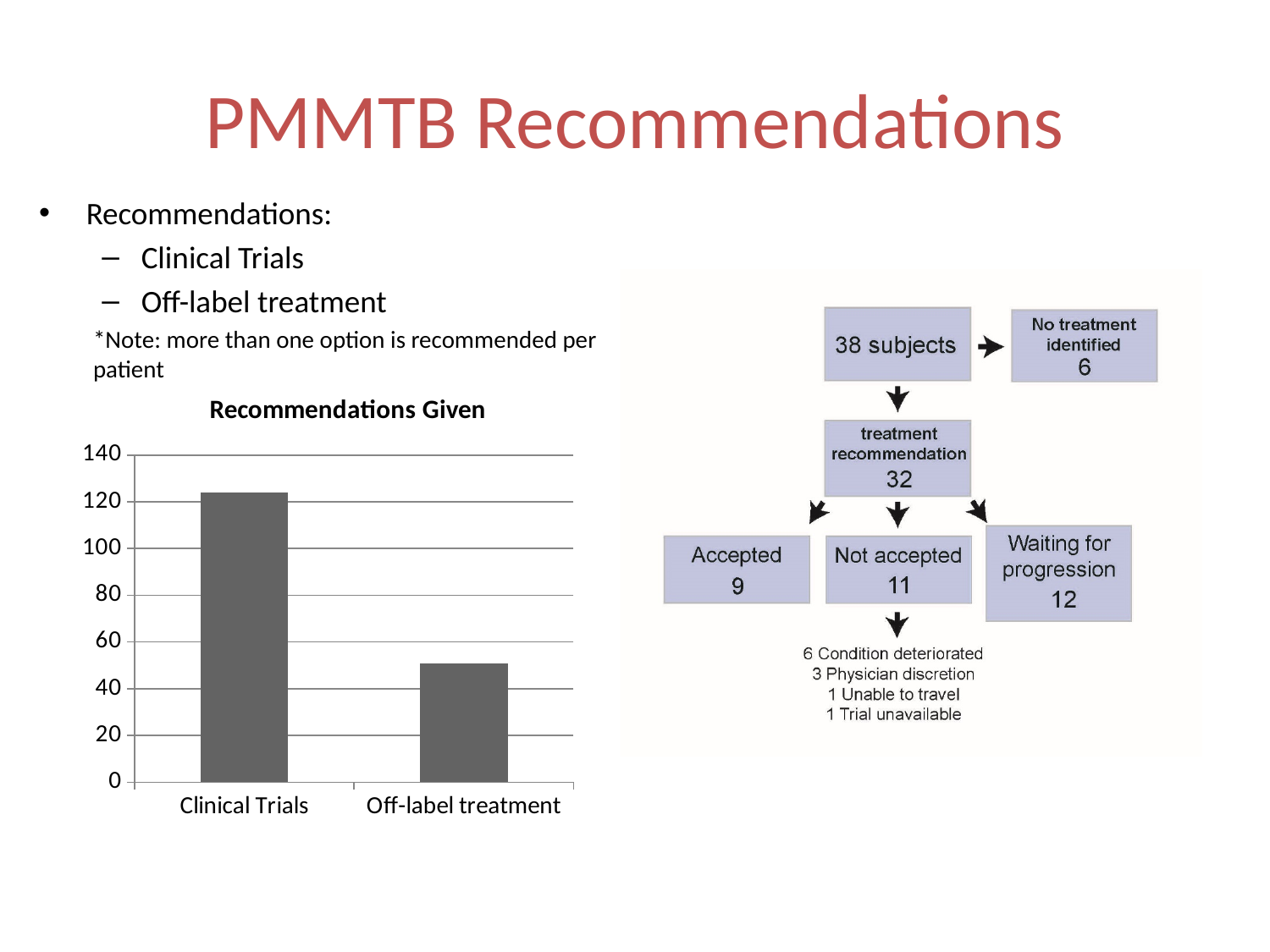
In the 'Recommendations Given' chart, is the value for Off-label treatment greater or less than 60? less In the 'Recommendations Given' chart, is the value for Off-label treatment greater or less than 40? greater What is the title of the bar chart on the slide? Recommendations Given How many categories are shown on the x axis of the 'Recommendations Given' chart? 2 What kind of chart is 'Recommendations Given'? bar chart In the 'Recommendations Given' chart, which is larger: Clinical Trials or Off-label treatment? Clinical Trials In the 'Recommendations Given' chart, is the value for Clinical Trials greater or less than 100? greater In the 'Recommendations Given' chart, which category has the lowest value? Off-label treatment Do the values in the 'Recommendations Given' chart rise or fall from left to right along the x axis? fall What is the maximum value shown on the y axis of the 'Recommendations Given' chart? 140 In the 'Recommendations Given' chart, which category has the highest value? Clinical Trials